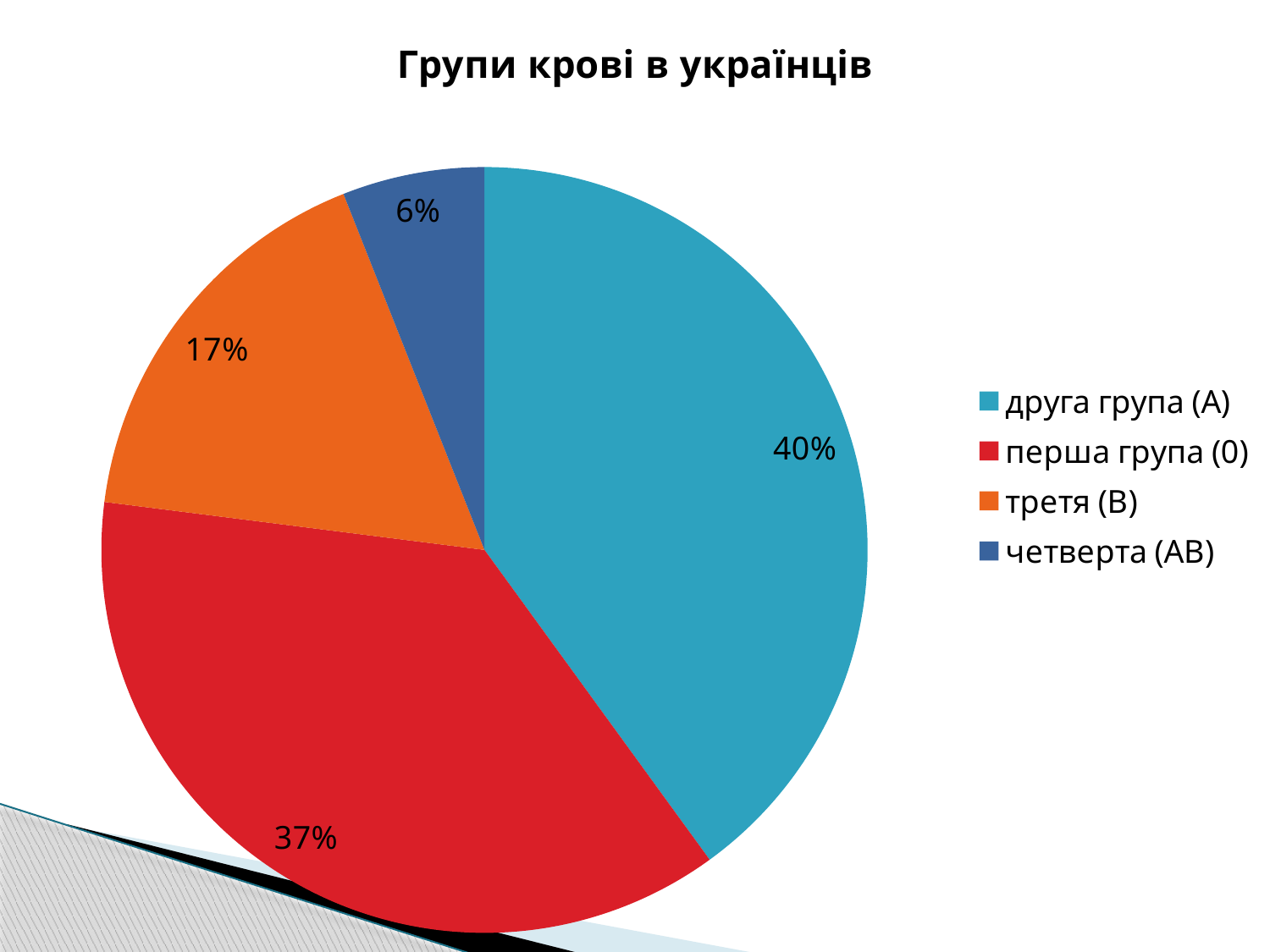
How many categories does the pie chart show? 4 Which is larger, the slice for третя (B) or the slice for четверта (AB)? третя (B) What share of the pie does друга група (A) represent? 40% What kind of chart is shown on the slide? Pie chart What is the value shown for четверта (AB)? 6% Which blood group has the smallest slice of the pie? четверта (AB) What share of the pie does перша група (0) represent? 37% What is the value shown for третя (B)? 17% Which blood group has the largest slice of the pie? друга група (A) What is the difference in percentage points between друга група (A) and перша група (0)? 3% What is the difference in percentage points between третя (B) and четверта (AB)? 11% What is the title of the chart? Групи крові в українців